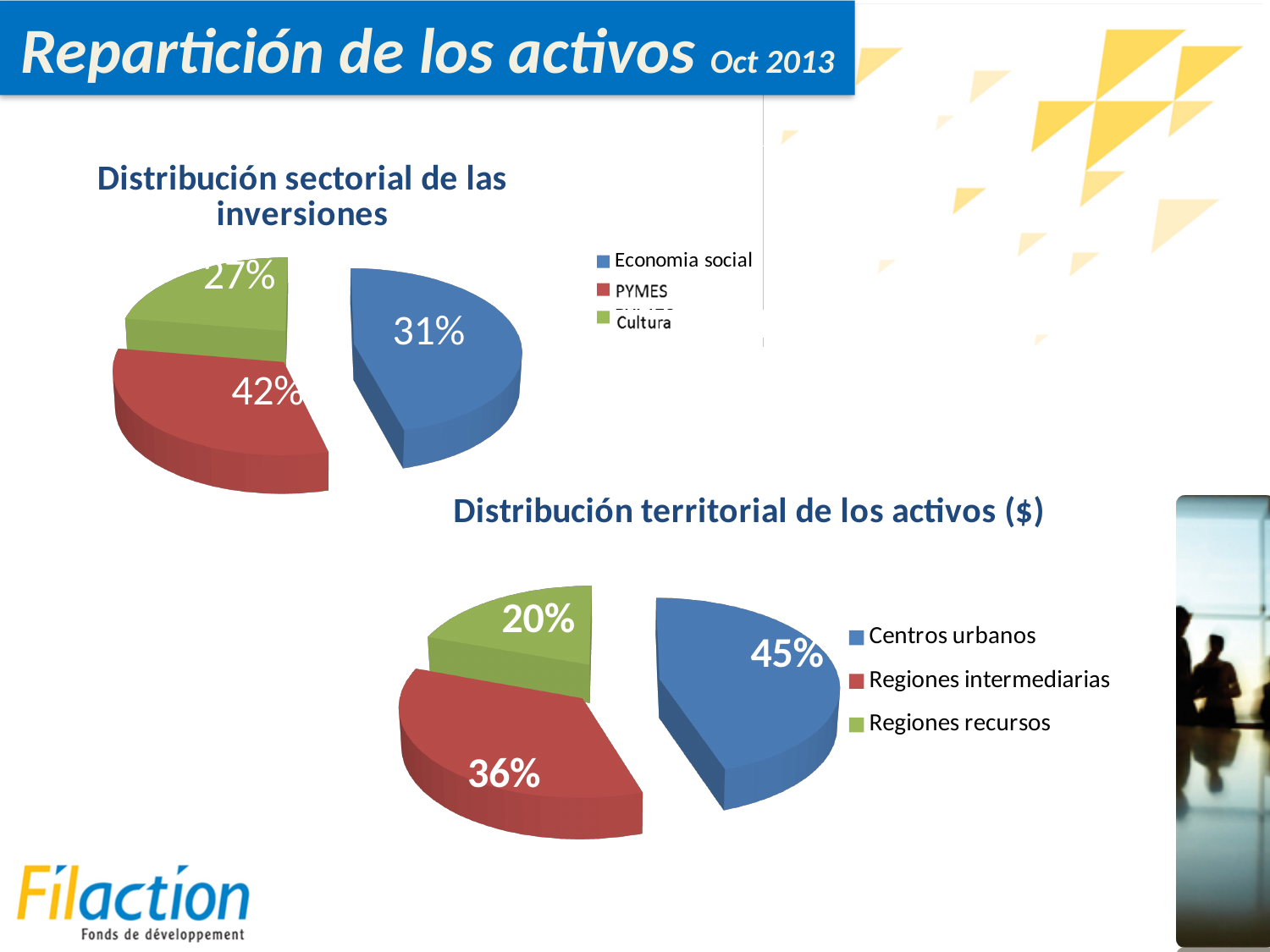
What type of chart is the 'Distribución territorial de los activos ($)' chart? Pie chart In the 'Distribución territorial de los activos ($)' chart, which region type has the smallest share? Regiones recursos In the 'Distribución sectorial de las inversiones' chart, which sector has the largest share? PYMES In the 'Distribución sectorial de las inversiones' chart, which sector has the smallest share? Cultura In the 'Distribución sectorial de las inversiones' chart, how many slices does the pie have? 3 In the 'Distribución sectorial de las inversiones' chart, what share does PYMES have? 42% In the 'Distribución territorial de los activos ($)' chart, which is larger: Regiones intermediarias or Regiones recursos? Regiones intermediarias In the 'Distribución sectorial de las inversiones' chart, what share does Cultura have? 27% In the 'Distribución sectorial de las inversiones' chart, what is the difference between the PYMES share and the Economia social share? 11% In the 'Distribución territorial de los activos ($)' chart, what is the difference between the Centros urbanos share and the Regiones intermediarias share? 9% In the 'Distribución territorial de los activos ($)' chart, what share do Centros urbanos have? 45% In the 'Distribución territorial de los activos ($)' chart, what share do Regiones recursos have? 20%